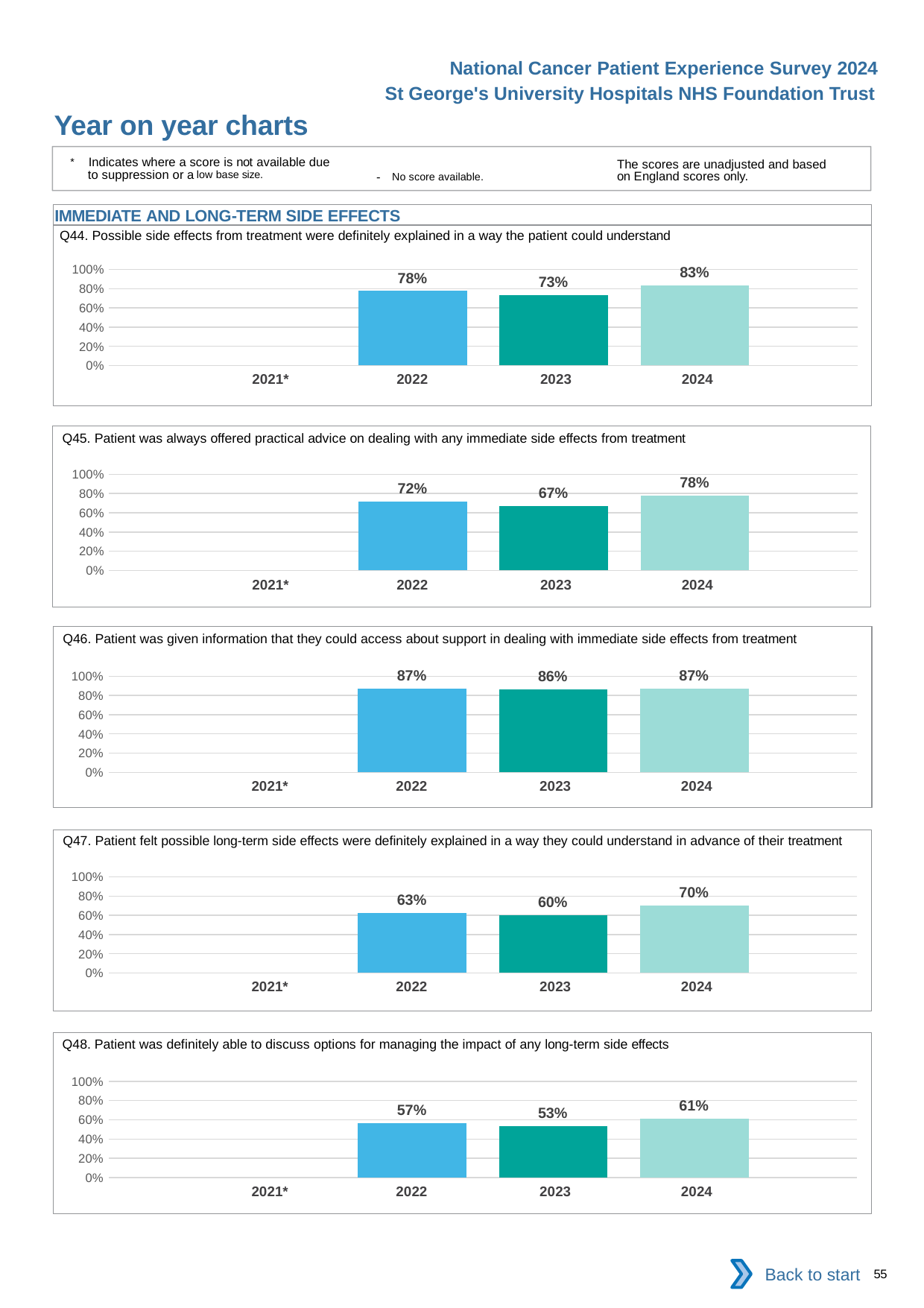
In the Q48 chart, what is the value for 2024? 61% In the Q47 chart, what is the difference between the 2022 and 2023 values? 3% In the Q47 chart, which year has the highest value? 2024 In the Q48 chart, which is larger, the value for 2022 or the value for 2023? 2022 In the Q44 chart, what is the value for 2024? 83% In the Q46 chart, what is the value for 2023? 86% In the Q44 chart, which year has the lowest value among those with a score? 2023 How many year categories are shown on the x axis of the Q48 chart? 4 In the Q46 chart, is the value for 2022 greater or less than 80%? greater In the Q45 chart, what is the difference between the 2024 and 2023 values? 11% What type of chart is used for Q44? Bar chart In the Q45 chart, what is the value for 2022? 72%